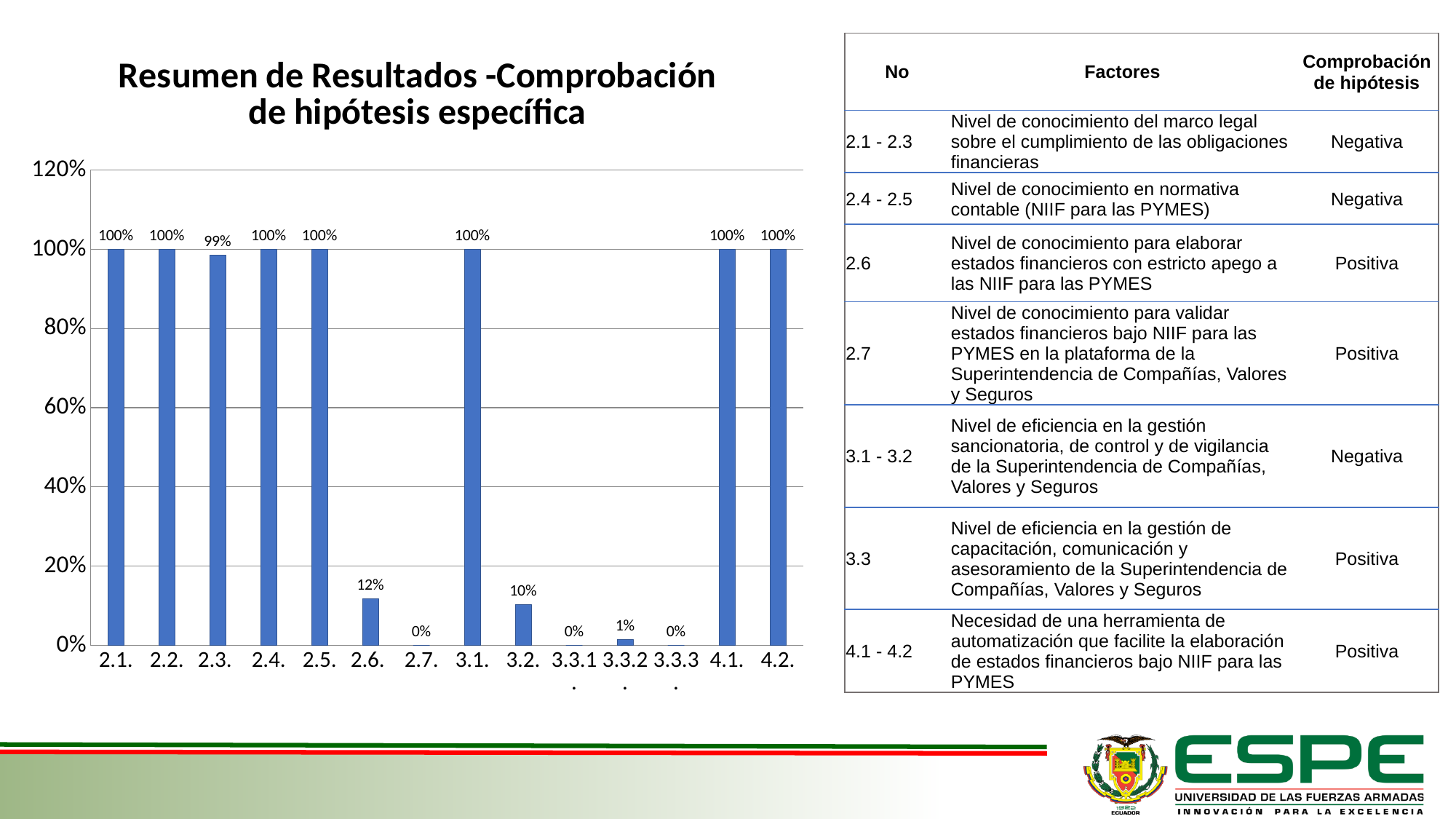
Which category has the lowest non-zero value in the chart? 3.3.2. What is the value for category 3.3.2. in the chart? 1% What type of chart is shown on the slide? bar chart What is the title of the chart? Resumen de Resultados -Comprobación de hipótesis específica What is the value for category 3.2. in the chart? 10% What is the value for category 2.6. in the chart? 12% Is the value for 2.6. greater or less than 20%? less Which is larger, the value for 2.6. or the value for 3.2.? 2.6. How many categories are shown on the x axis of the chart? 14 What is the value for category 2.3. in the chart? 99% What is the value for category 2.7. in the chart? 0% What is the difference between the values for 2.6. and 3.2.? 2%